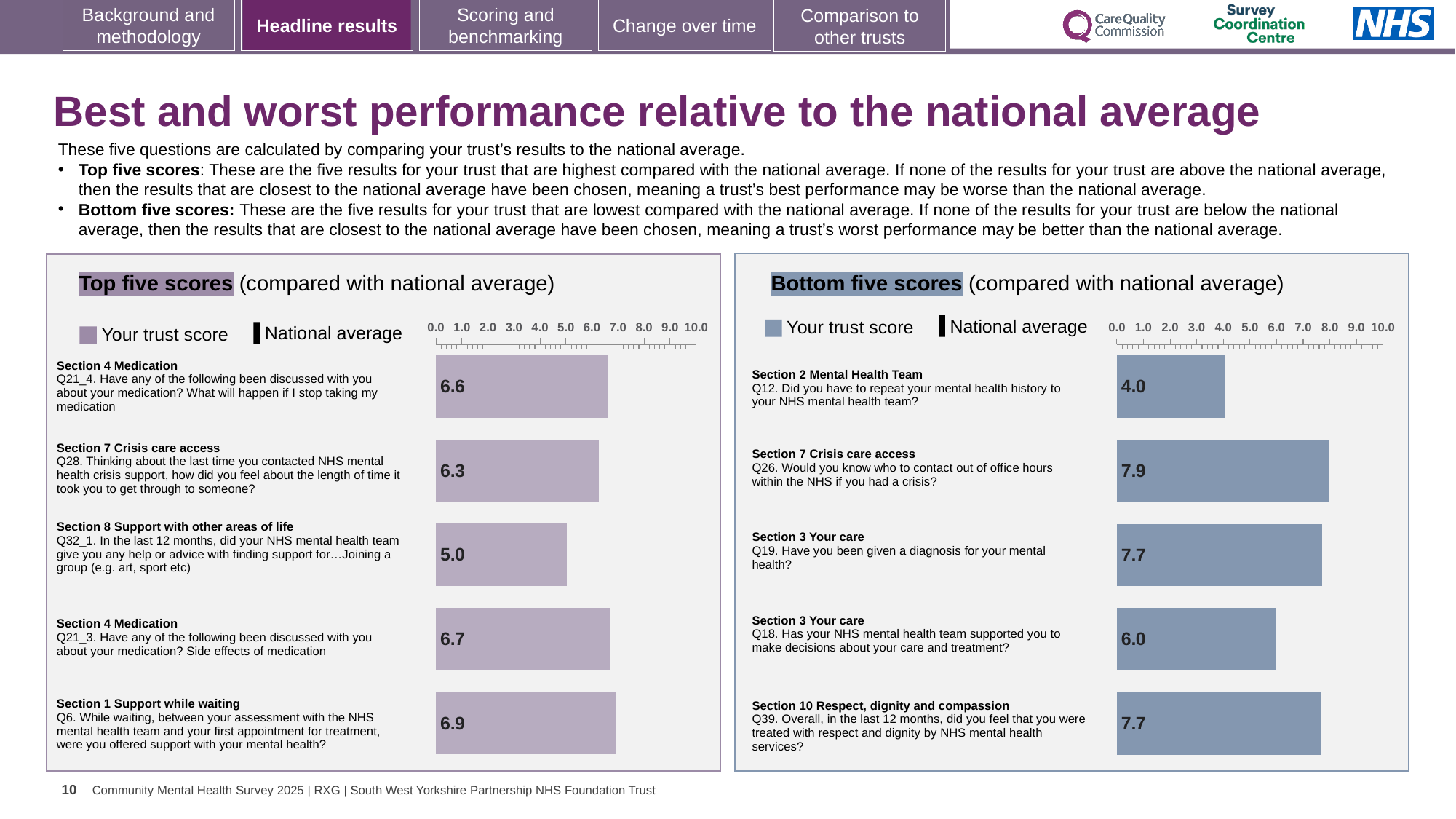
In the Top five scores chart, what is the difference between the trust scores for Q6 and Q32_1? 1.9 How many bars are plotted in the Bottom five scores chart? 5 In the Top five scores chart, which has the larger trust score: Q21_3 or Q28? Q21_3 In the Top five scores chart, which question has the highest trust score? Q6 (Section 1 Support while waiting) How many series does the legend of the Top five scores chart list? 2 In the Bottom five scores chart, what is the difference between the trust scores for Q26 and Q12? 3.9 What kind of chart is the Top five scores chart? Bar chart In the Bottom five scores chart, which question has the highest trust score? Q26 (Section 7 Crisis care access) In the Top five scores chart, what is the trust score for Q6 (Section 1 Support while waiting)? 6.9 In the Bottom five scores chart, which question has the lowest trust score? Q12 (Section 2 Mental Health Team) In the Top five scores chart, which question has the lowest trust score? Q32_1 (Section 8 Support with other areas of life) In the Bottom five scores chart, what is the trust score for Q12 (Section 2 Mental Health Team)? 4.0